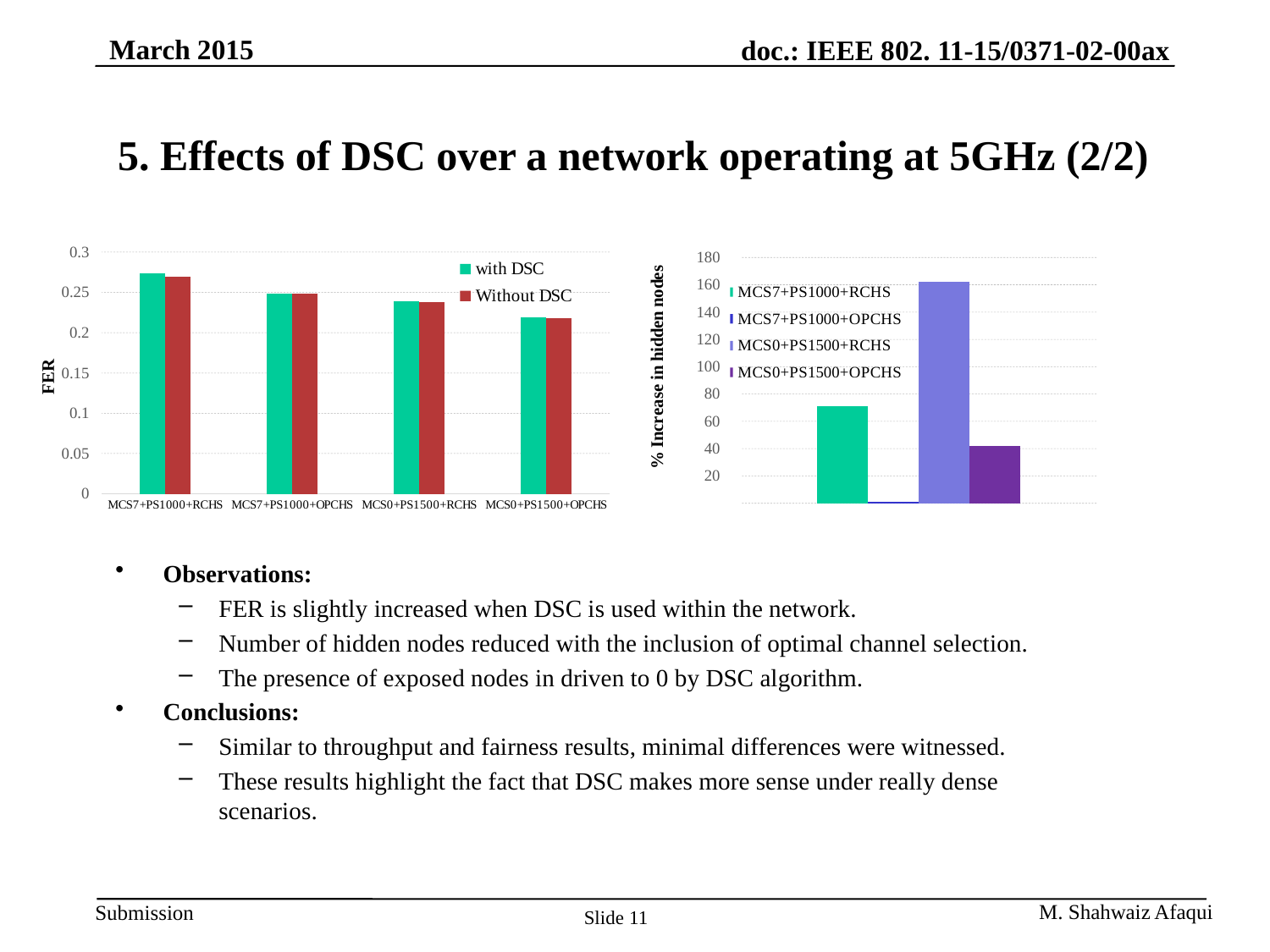
In the right chart (% Increase in hidden nodes), which configuration has the lowest value? MCS7+PS1000+OPCHS In the right chart (% Increase in hidden nodes), which is larger: MCS7+PS1000+RCHS or MCS0+PS1500+OPCHS? MCS7+PS1000+RCHS In the left FER chart, is the 'with DSC' value for MCS7+PS1000+RCHS greater or less than 0.25? greater What kind of chart is the left chart with the FER axis? bar chart In the left FER chart, how many series does the legend list? 2 In the left FER chart, how many categories are shown on the x axis? 4 In the left FER chart, which category has the lowest FER for the 'Without DSC' series? MCS0+PS1500+OPCHS In the left FER chart, is the 'Without DSC' value for MCS0+PS1500+OPCHS greater or less than 0.25? less In the right chart (% Increase in hidden nodes), is the value for MCS0+PS1500+RCHS greater or less than 140? greater In the left FER chart, do the 'with DSC' values rise or fall moving from left to right along the x axis? fall In the right chart (% Increase in hidden nodes), which configuration has the highest value? MCS0+PS1500+RCHS In the left FER chart, which category has the highest FER for the 'with DSC' series? MCS7+PS1000+RCHS